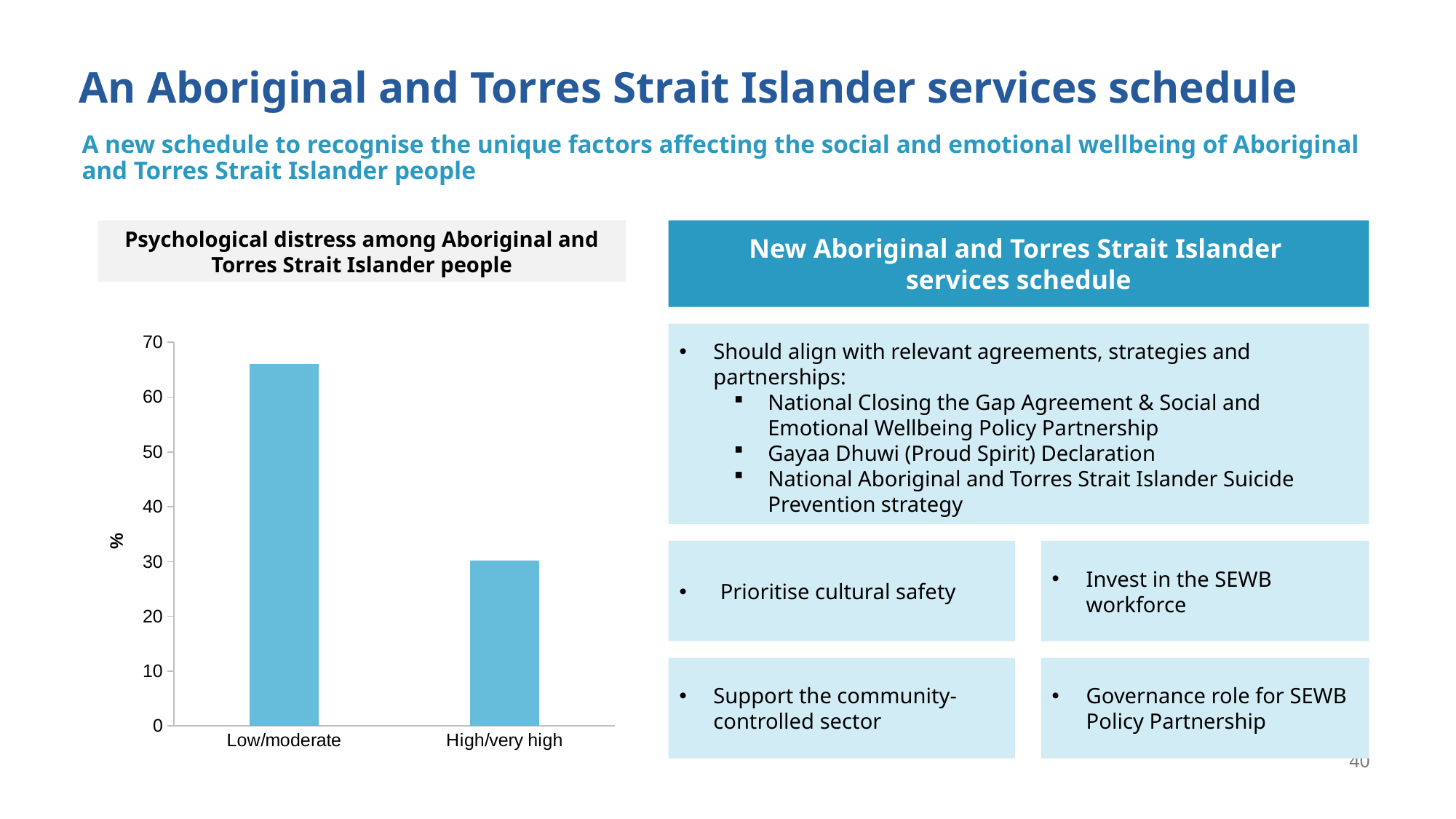
Which category has the highest value in the chart? Low/moderate Which category has the lowest value in the chart? High/very high Which is larger, the value for Low/moderate or the value for High/very high? Low/moderate What is the title of the chart? Psychological distress among Aboriginal and Torres Strait Islander people What is the highest tick value shown on the y axis of the chart? 70 Is the value for Low/moderate greater or less than 70? less How many categories are shown on the x axis of the chart? 2 What is the label on the y axis of the chart? % Is the value for High/very high greater or less than 20? greater Is the value for High/very high greater or less than 40? less What kind of chart is shown on the slide? bar chart